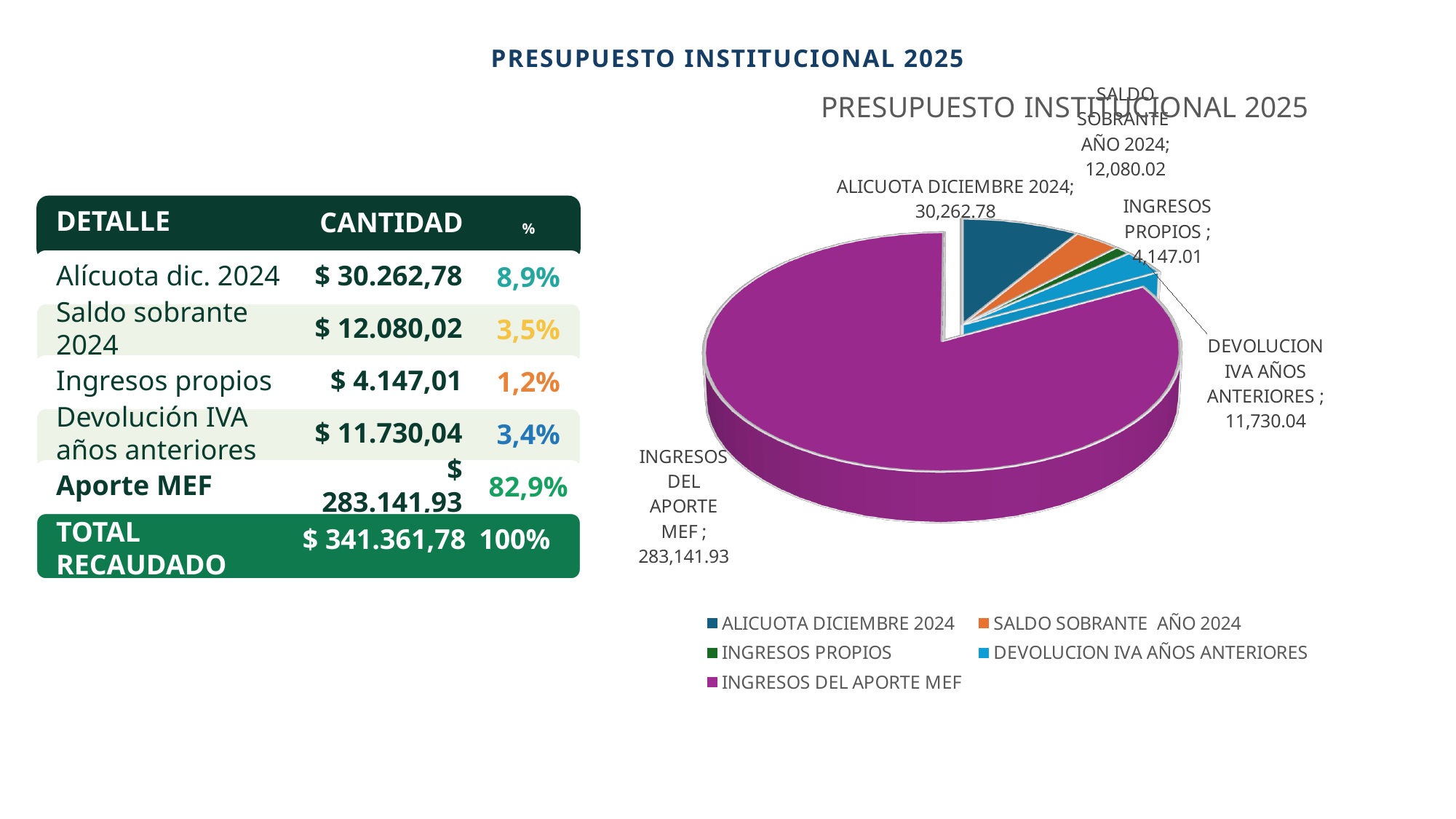
Which slice of the pie chart is the largest? INGRESOS DEL APORTE MEF Which slice of the pie chart is the smallest? INGRESOS PROPIOS In the pie chart, what is the difference between ALICUOTA DICIEMBRE 2024 and SALDO SOBRANTE AÑO 2024? 18,182.76 What value is shown for DEVOLUCION IVA AÑOS ANTERIORES in the pie chart? 11,730.04 What value is shown for ALICUOTA DICIEMBRE 2024 in the pie chart? 30,262.78 What value is shown for INGRESOS DEL APORTE MEF in the pie chart? 283,141.93 What value is shown for INGRESOS PROPIOS in the pie chart? 4,147.01 How many entries does the pie chart's legend list? 5 What kind of chart is shown on the slide? Pie chart In the pie chart, which is larger: SALDO SOBRANTE AÑO 2024 or DEVOLUCION IVA AÑOS ANTERIORES? SALDO SOBRANTE AÑO 2024 How many slices does the pie chart have? 5 What is the title of the pie chart? PRESUPUESTO INSTITUCIONAL 2025